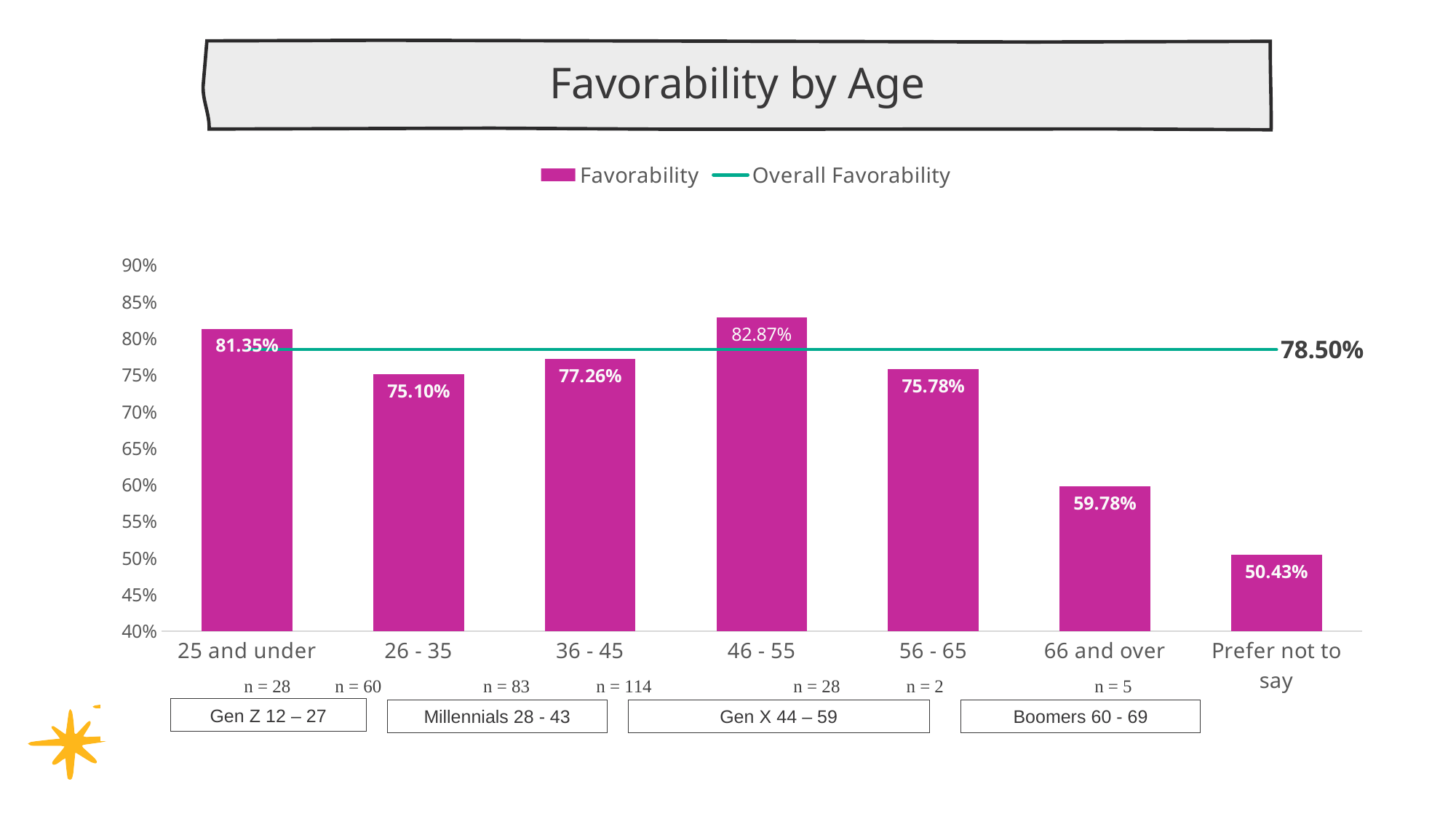
What kind of chart is used to show favorability by age group? Bar chart Which category has the lowest favorability? Prefer not to say What is the favorability for the 66 and over age group? 59.78% How many age categories are shown on the x axis? 7 Which has higher favorability, the 36 - 45 group or the 56 - 65 group? 36 - 45 Which age group has the highest favorability? 46 - 55 What is the Overall Favorability value shown by the line? 78.50% Is the favorability for the 25 and under group greater or less than the Overall Favorability line? greater What is the favorability for the 46 - 55 age group? 82.87% What is the difference in favorability between the 46 - 55 group and the 26 - 35 group? 7.77% How many series does the legend list? 2 What is the title of the chart? Favorability by Age